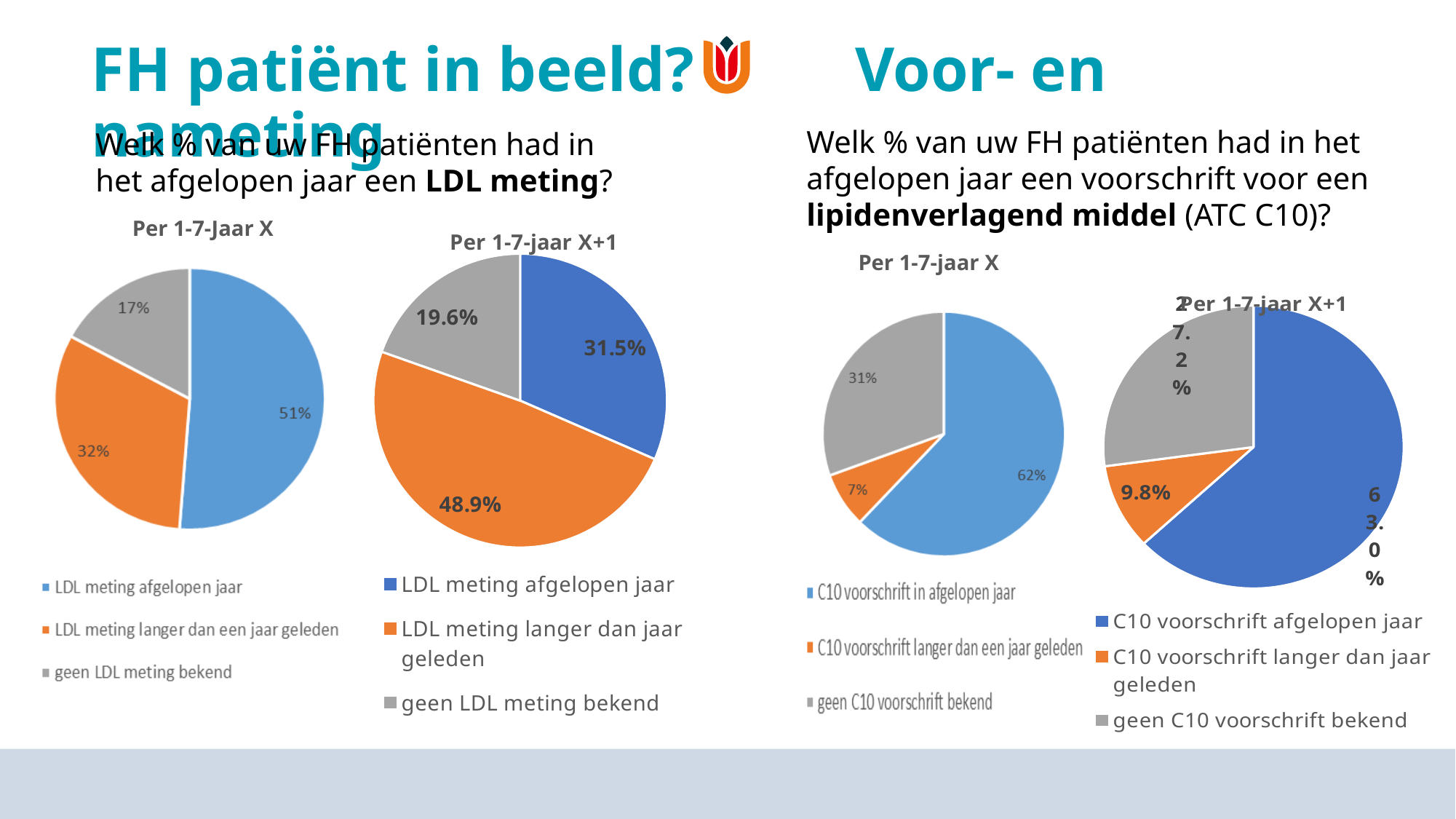
In the LDL meting pie chart titled 'Per 1-7-Jaar X', which category has the smallest slice? geen LDL meting bekend In the C10 voorschrift pie chart titled 'Per 1-7-jaar X+1', what percentage is shown for 'C10 voorschrift langer dan jaar geleden'? 9.8% In the LDL meting pie chart titled 'Per 1-7-jaar X+1', what percentage is shown for 'LDL meting afgelopen jaar'? 31.5% In the LDL meting pie chart titled 'Per 1-7-jaar X+1', what percentage is shown for 'LDL meting langer dan jaar geleden'? 48.9% In the LDL meting pie chart titled 'Per 1-7-Jaar X', what percentage is shown for 'geen LDL meting bekend'? 17% In the LDL meting pie chart titled 'Per 1-7-jaar X+1', which category has the largest slice? LDL meting langer dan jaar geleden What type of chart is used for the LDL meting data titled 'Per 1-7-Jaar X'? Pie chart In the C10 voorschrift pie chart titled 'Per 1-7-jaar X', what percentage is shown for 'C10 voorschrift in afgelopen jaar'? 62% In the LDL meting pie chart titled 'Per 1-7-Jaar X', what is the difference between the 'LDL meting afgelopen jaar' and 'LDL meting langer dan een jaar geleden' slices? 19% How many slices does the C10 voorschrift pie chart titled 'Per 1-7-jaar X' have? 3 In the LDL meting pie chart titled 'Per 1-7-Jaar X', what percentage is shown for 'LDL meting afgelopen jaar'? 51% In the C10 voorschrift pie chart titled 'Per 1-7-jaar X', what percentage is shown for 'C10 voorschrift langer dan een jaar geleden'? 7%